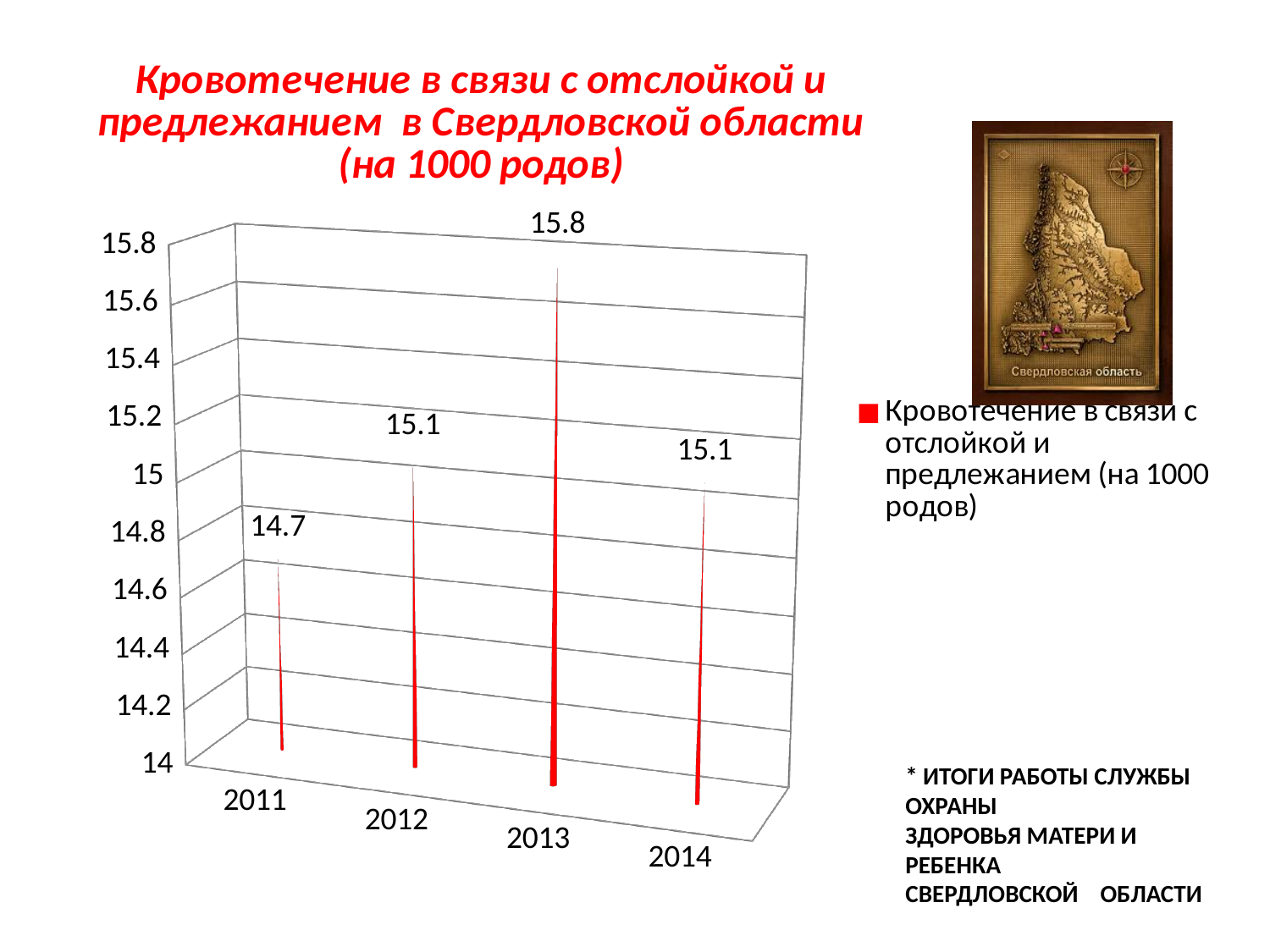
How many series does the legend list? 1 What is the difference between the values for 2013 and 2011? 1.1 What is the value for 2013? 15.8 What kind of chart is shown on the slide? bar chart What is the value for 2011? 14.7 Which year has the lowest value? 2011 What colour are the bars in the chart? red Which year has the highest value? 2013 How many years are shown on the x axis? 4 Which is larger, the value for 2013 or the value for 2014? 2013 What is the difference between the values for 2012 and 2011? 0.4 What is the value for 2014? 15.1